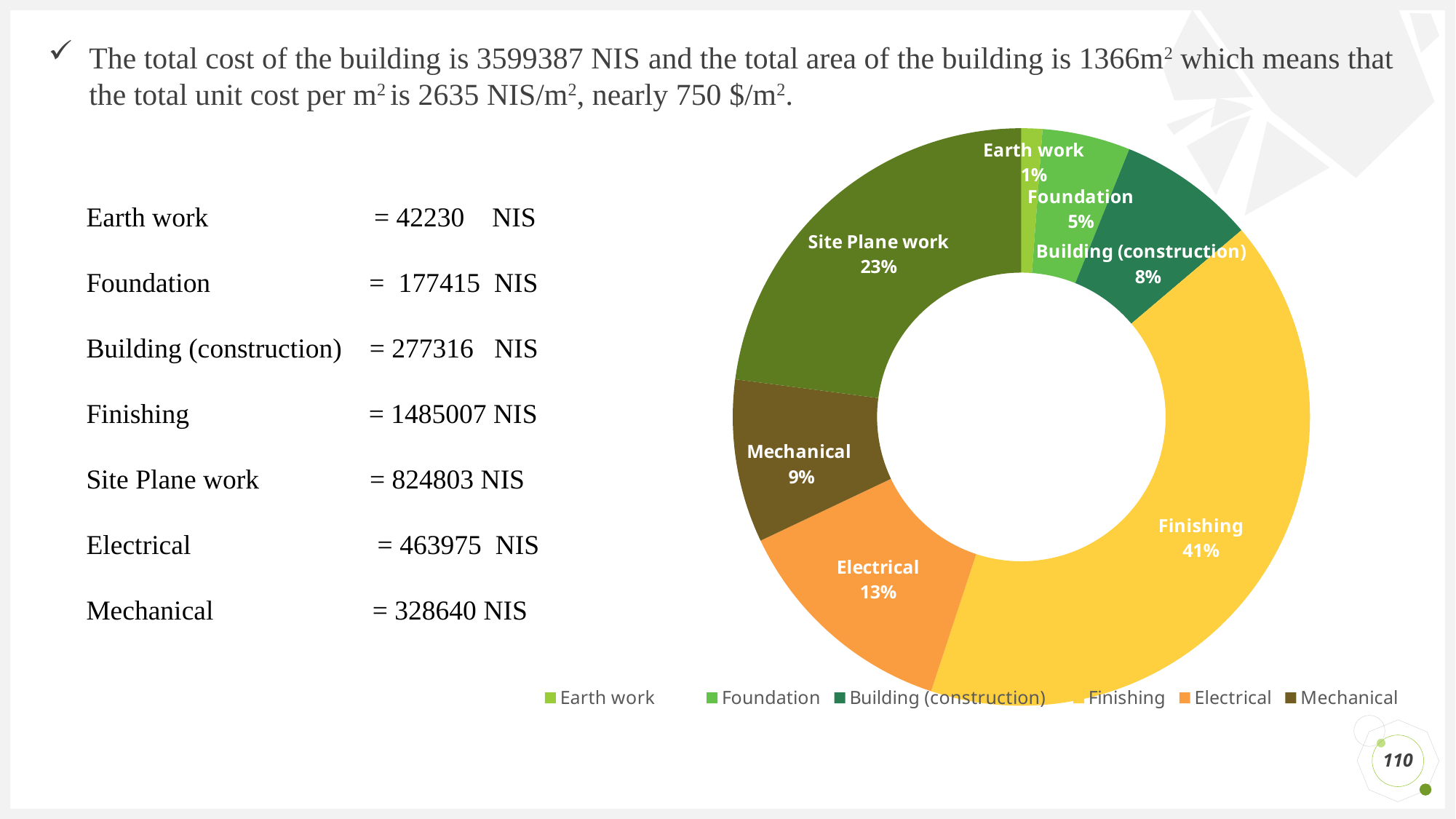
What is the difference in percentage points between the Finishing share and the Site Plane work share? 18 What share of the pie does Building (construction) represent? 8% How many categories are shown in the pie chart? 7 Which category has the smallest slice of the pie? Earth work Which category has the largest slice of the pie? Finishing What share of the pie does Finishing represent? 41% What kind of chart is shown on the slide? Pie chart (doughnut) What share of the pie does Mechanical represent? 9% Which category is shown in orange in the pie chart? Electrical Which is larger, the share for Electrical or the share for Mechanical? Electrical